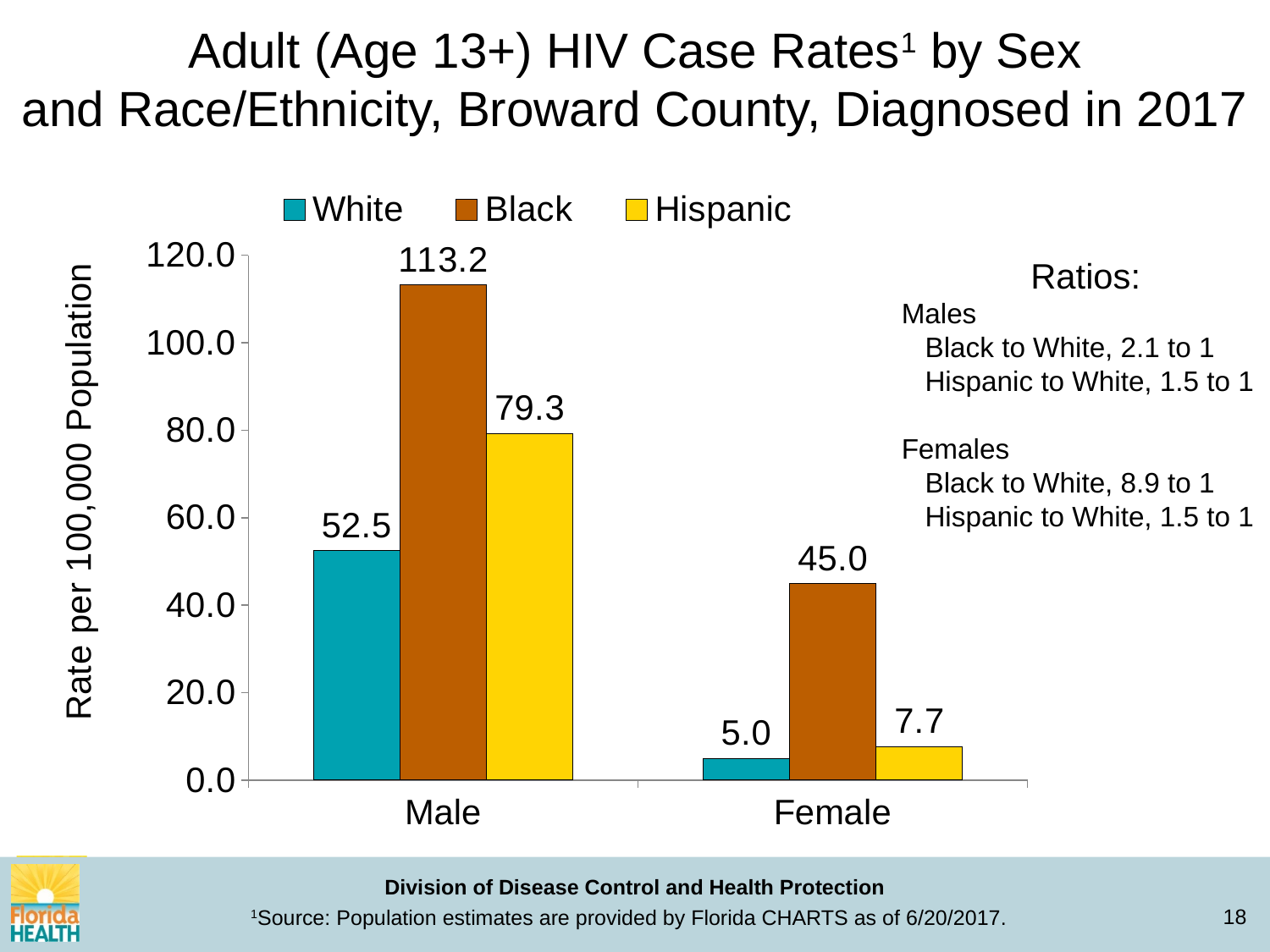
What is the HIV case rate for Black males? 113.2 What is the difference between the Hispanic female rate and the White female rate? 2.7 Which is larger, the Hispanic male rate or the Black female rate? Hispanic male rate What is the HIV case rate for Hispanic males? 79.3 What is the HIV case rate for White females? 5.0 Which race/ethnicity has the highest case rate among females? Black How many series does the legend list? 3 What kind of chart is shown on the slide? Bar chart Is the value for Black males greater or less than 100.0? greater Which race/ethnicity has the lowest case rate among males? White What is the difference between the Black male rate and the White male rate? 60.7 What is the label of the vertical axis? Rate per 100,000 Population